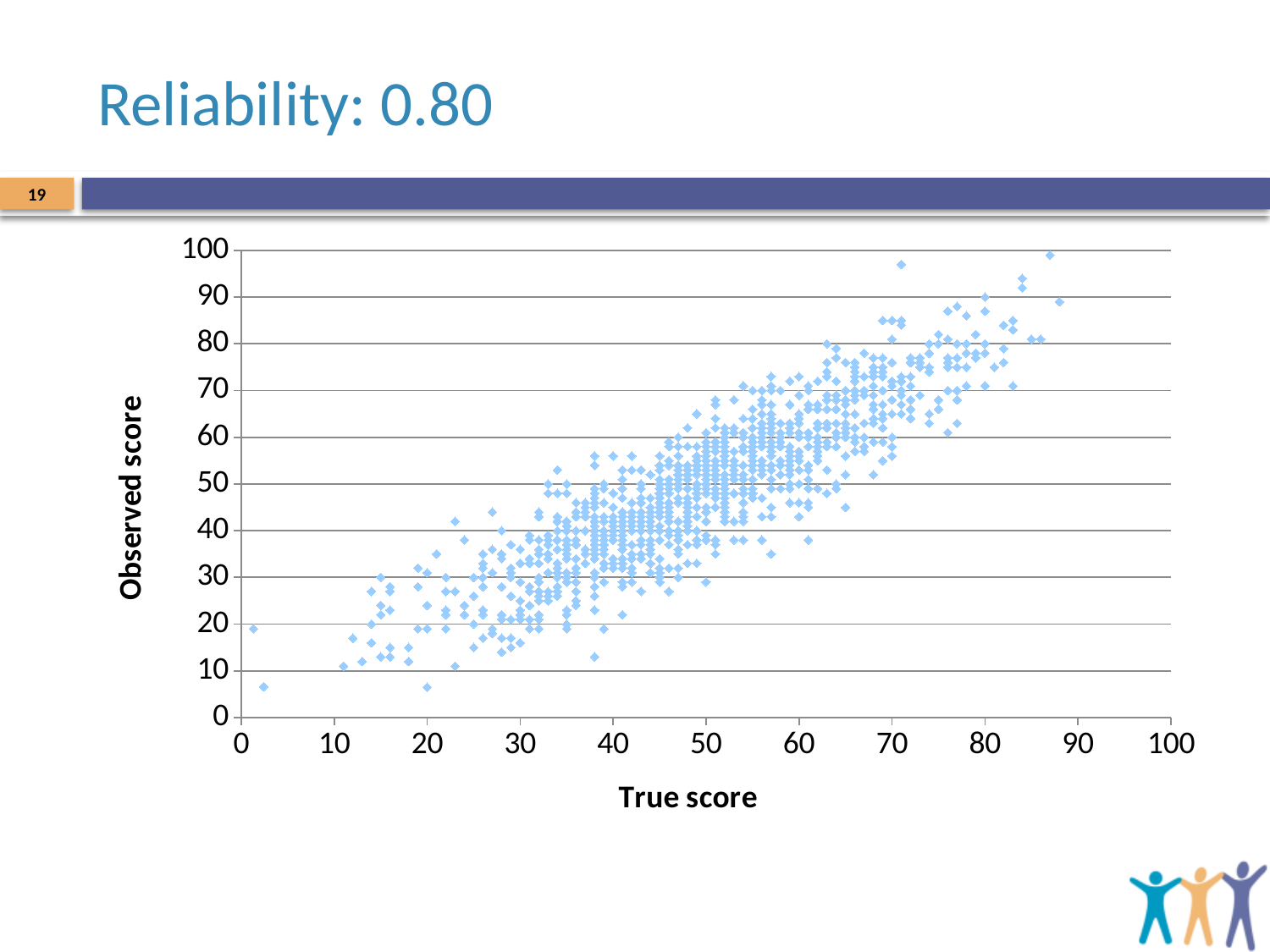
Is the highest true score plotted greater or less than 90? less What is the title of the slide containing the chart? Reliability: 0.80 What is the label of the y axis? Observed score What is the maximum value shown on the y axis? 100 What is the maximum value shown on the x axis? 100 What is the interval between tick marks on the y axis? 10 Is the lowest true score plotted greater or less than 10? less Is the lowest observed score plotted greater or less than 10? less What is the label of the x axis? True score What kind of chart is shown on the slide? scatter plot As true score increases along the x axis, do observed scores generally rise or fall? rise